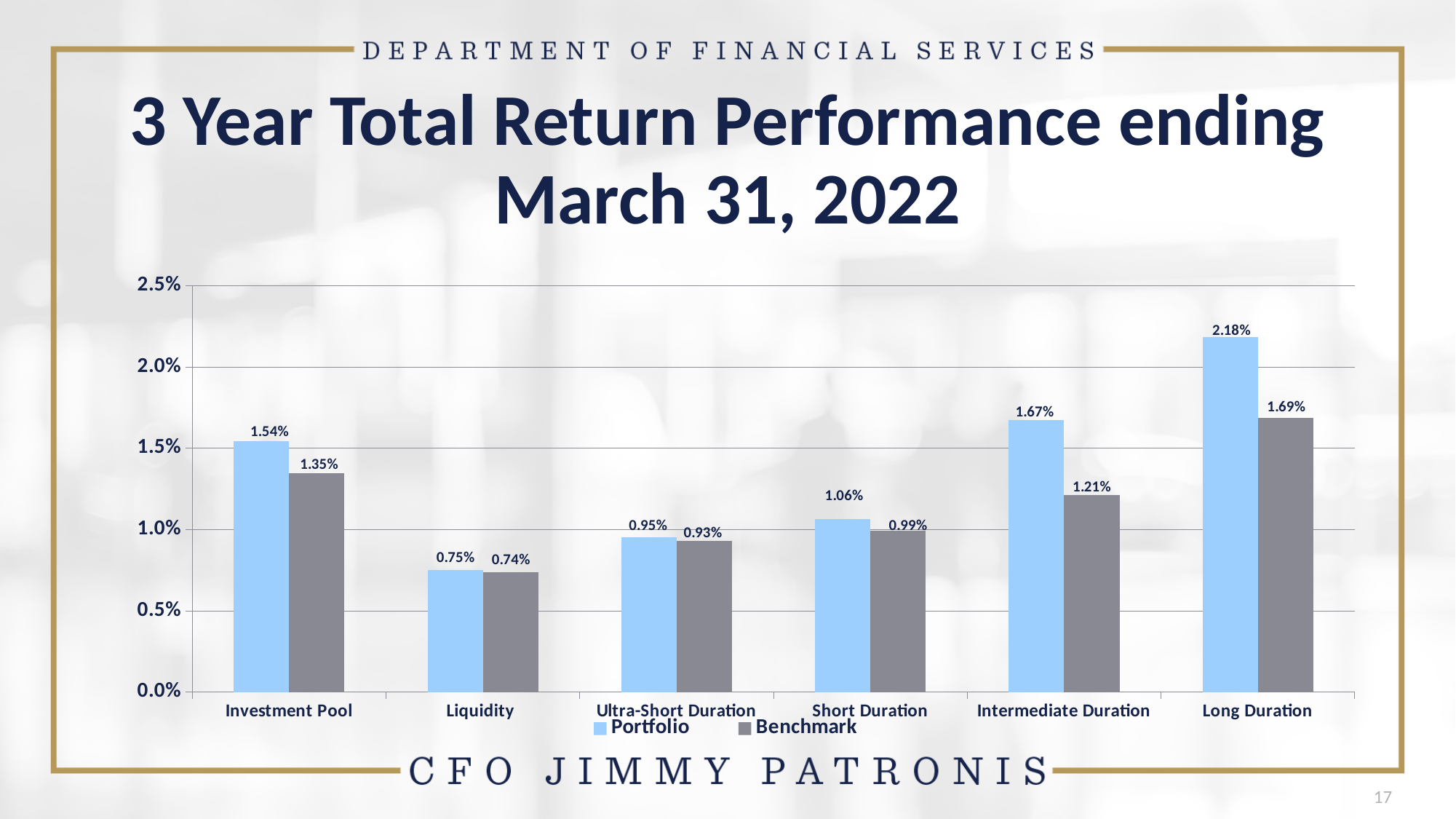
Which series is shown in light blue? Portfolio How many categories are shown on the x axis? 6 What is the Benchmark value for Investment Pool? 1.35% How many series does the legend list? 2 What is the Portfolio value for Long Duration? 2.18% What is the difference between the Portfolio and Benchmark values for Intermediate Duration? 0.46% What is the Benchmark value for Intermediate Duration? 1.21% Which is larger for Long Duration, the Portfolio value or the Benchmark value? Portfolio Which category has the highest Portfolio value? Long Duration Which category has the lowest Benchmark value? Liquidity What kind of chart is shown on the slide? Bar chart What is the Portfolio value for Short Duration? 1.06%